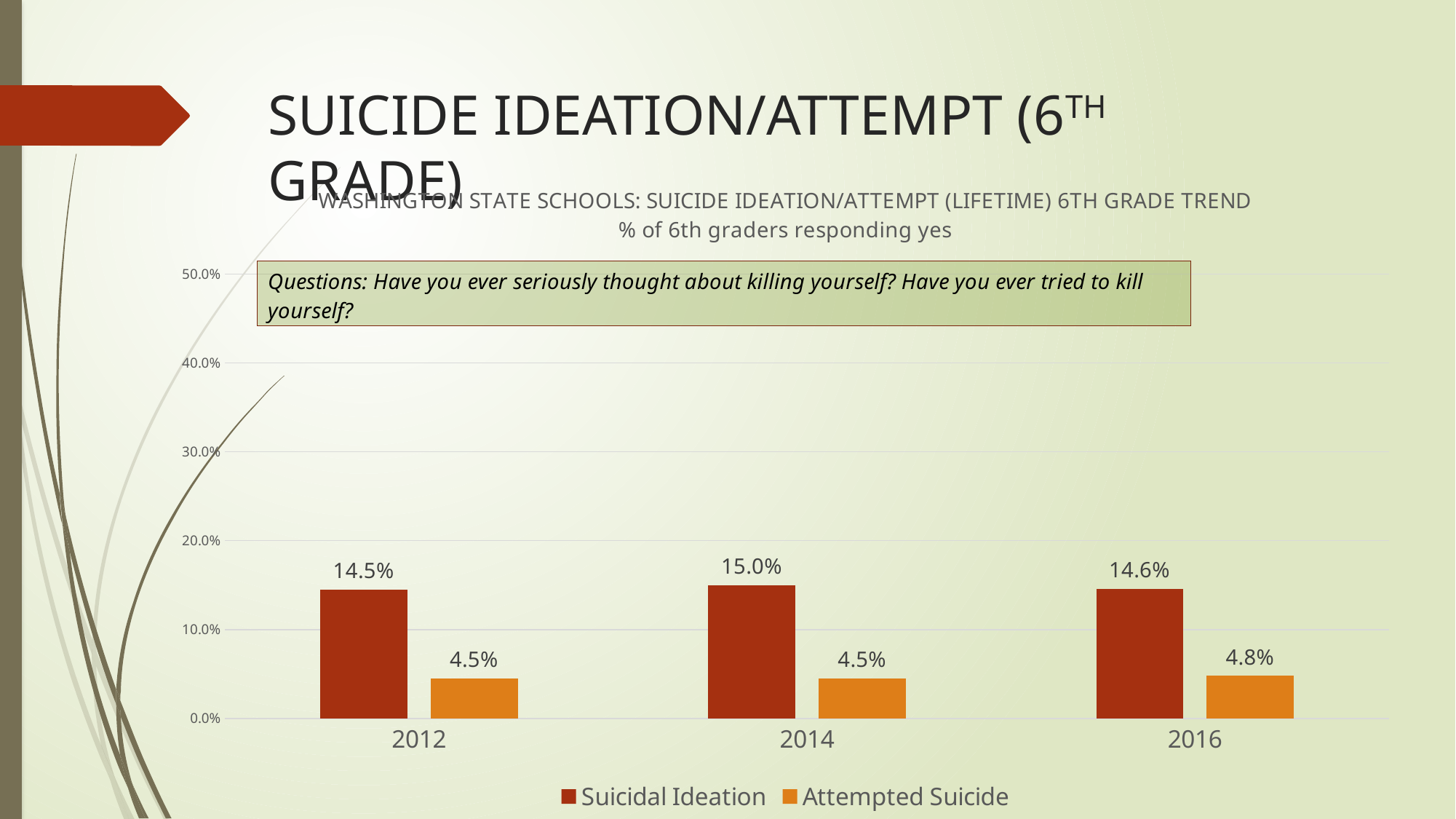
What is the value for Suicidal Ideation in 2014? 15.0% What kind of chart is shown on the slide? bar chart What is the difference between Suicidal Ideation in 2014 and in 2012? 0.5% How many years are shown on the x axis? 3 What is the value for Attempted Suicide in 2016? 4.8% How many series does the legend list? 2 In which year is Suicidal Ideation highest? 2014 What is the value for Suicidal Ideation in 2012? 14.5% Is the value for Suicidal Ideation in 2016 greater or less than 20.0%? less Which is larger in 2016, Suicidal Ideation or Attempted Suicide? Suicidal Ideation What is the difference between Suicidal Ideation and Attempted Suicide in 2014? 10.5% In which year is Attempted Suicide highest? 2016